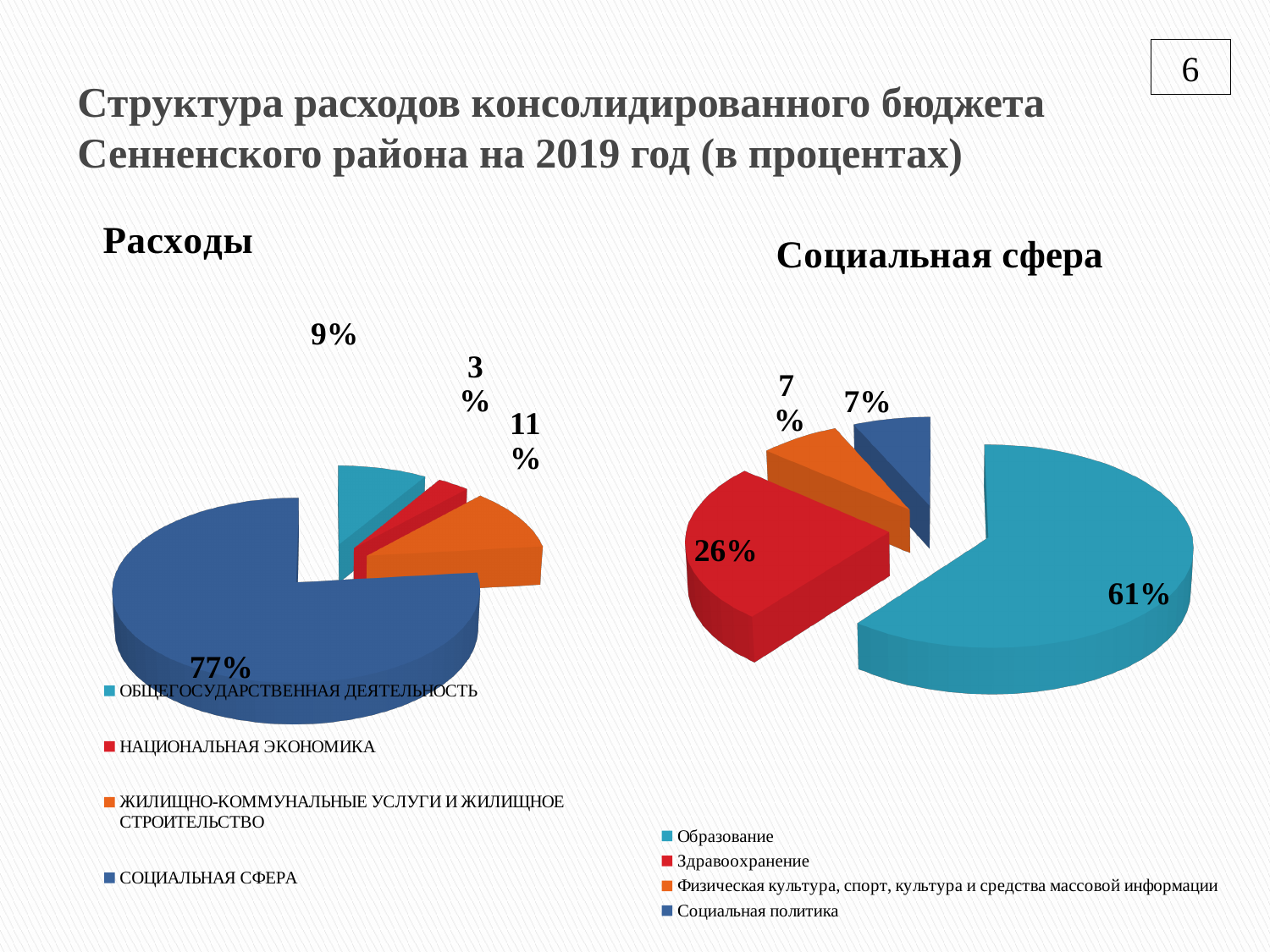
In the "Расходы" chart, how many categories does the legend list? 4 In the "Расходы" chart, what share is labelled for ЖИЛИЩНО-КОММУНАЛЬНЫЕ УСЛУГИ И ЖИЛИЩНОЕ СТРОИТЕЛЬСТВО? 11% In the "Расходы" chart, what share is labelled for СОЦИАЛЬНАЯ СФЕРА? 77% In the "Социальная сфера" chart, which is larger: Здравоохранение or Социальная политика? Здравоохранение In the "Расходы" chart, what is the difference in percentage points between ОБЩЕГОСУДАРСТВЕННАЯ ДЕЯТЕЛЬНОСТЬ and НАЦИОНАЛЬНАЯ ЭКОНОМИКА? 6 In the "Социальная сфера" chart, what is the difference in percentage points between Образование and Здравоохранение? 35 In the "Социальная сфера" chart, what colour is the Здравоохранение slice? Red In the "Социальная сфера" chart, what share is labelled for Образование? 61% In the "Расходы" chart, which category has the smallest slice? НАЦИОНАЛЬНАЯ ЭКОНОМИКА In the "Социальная сфера" chart, what share is labelled for Здравоохранение? 26% In the "Социальная сфера" chart, which category has the largest slice? Образование What type of chart is the "Социальная сфера" chart? Pie chart